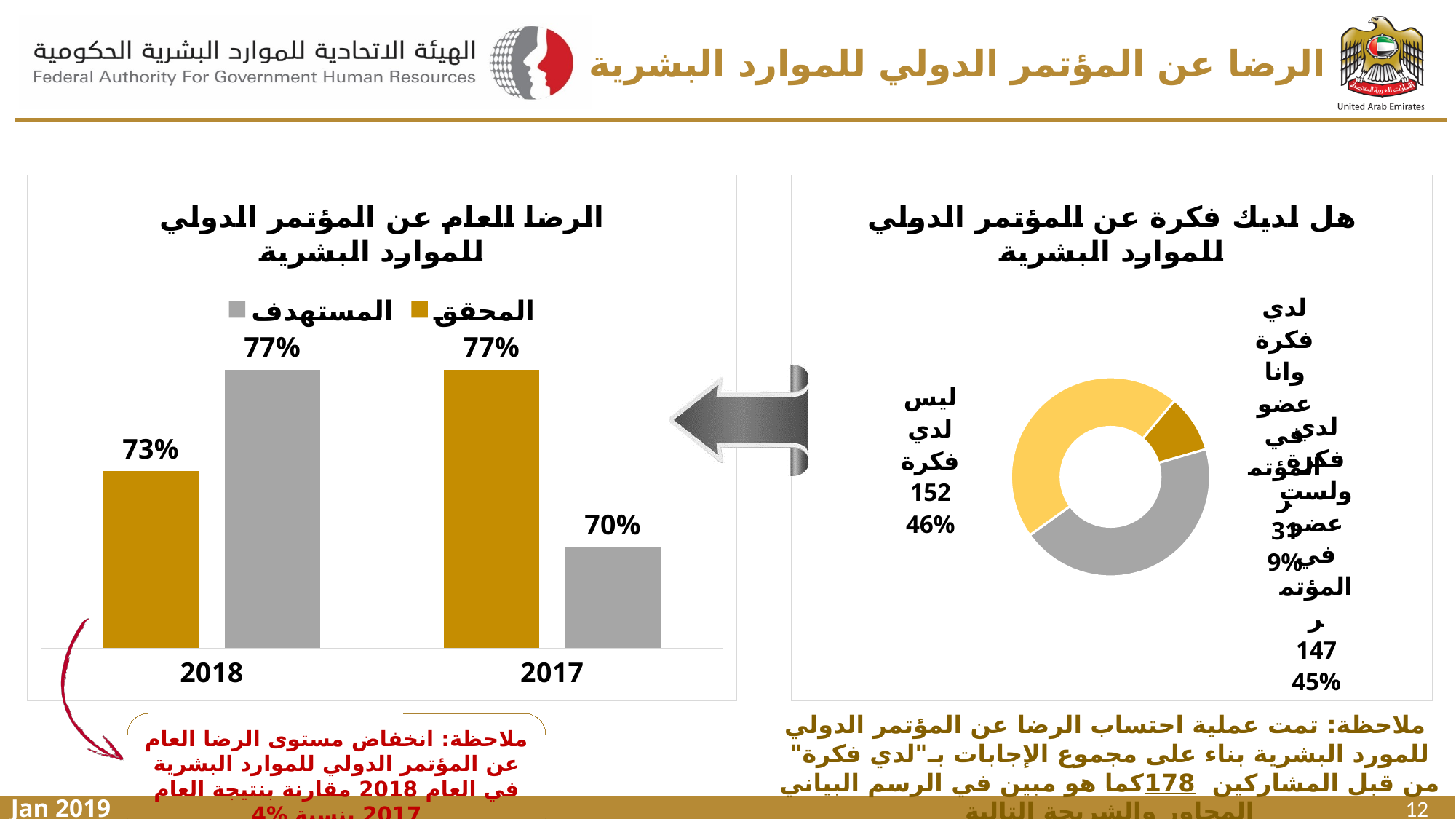
How many year categories are shown on the x axis of the bar chart on the left? 2 In the bar chart on the left, what is the difference between المستهدف and المحقق for 2018? 4% How many series does the legend of the bar chart on the left list? 2 What kind of chart is the chart on the left of the slide? Bar chart What kind of chart is the chart on the right of the slide? Donut (pie) chart In the bar chart on the left, which is larger for 2017, المحقق or المستهدف? المحقق In the bar chart titled 'الرضا العام عن المؤتمر الدولي للموارد البشرية', what is the value of المستهدف for 2017? 70% In the bar chart titled 'الرضا العام عن المؤتمر الدولي للموارد البشرية', what is the value of المحقق for 2018? 73% In the bar chart titled 'الرضا العام عن المؤتمر الدولي للموارد البشرية', what is the value of المحقق for 2017? 77% In the bar chart titled 'الرضا العام عن المؤتمر الدولي للموارد البشرية', what is the value of المستهدف for 2018? 77% In the chart titled 'هل لديك فكرة عن المؤتمر الدولي للموارد البشرية', what percentage is shown for 'ليس لدي فكرة'? 46% In the chart titled 'هل لديك فكرة عن المؤتمر الدولي للموارد البشرية', how many respondents are shown for 'ليس لدي فكرة'? 152